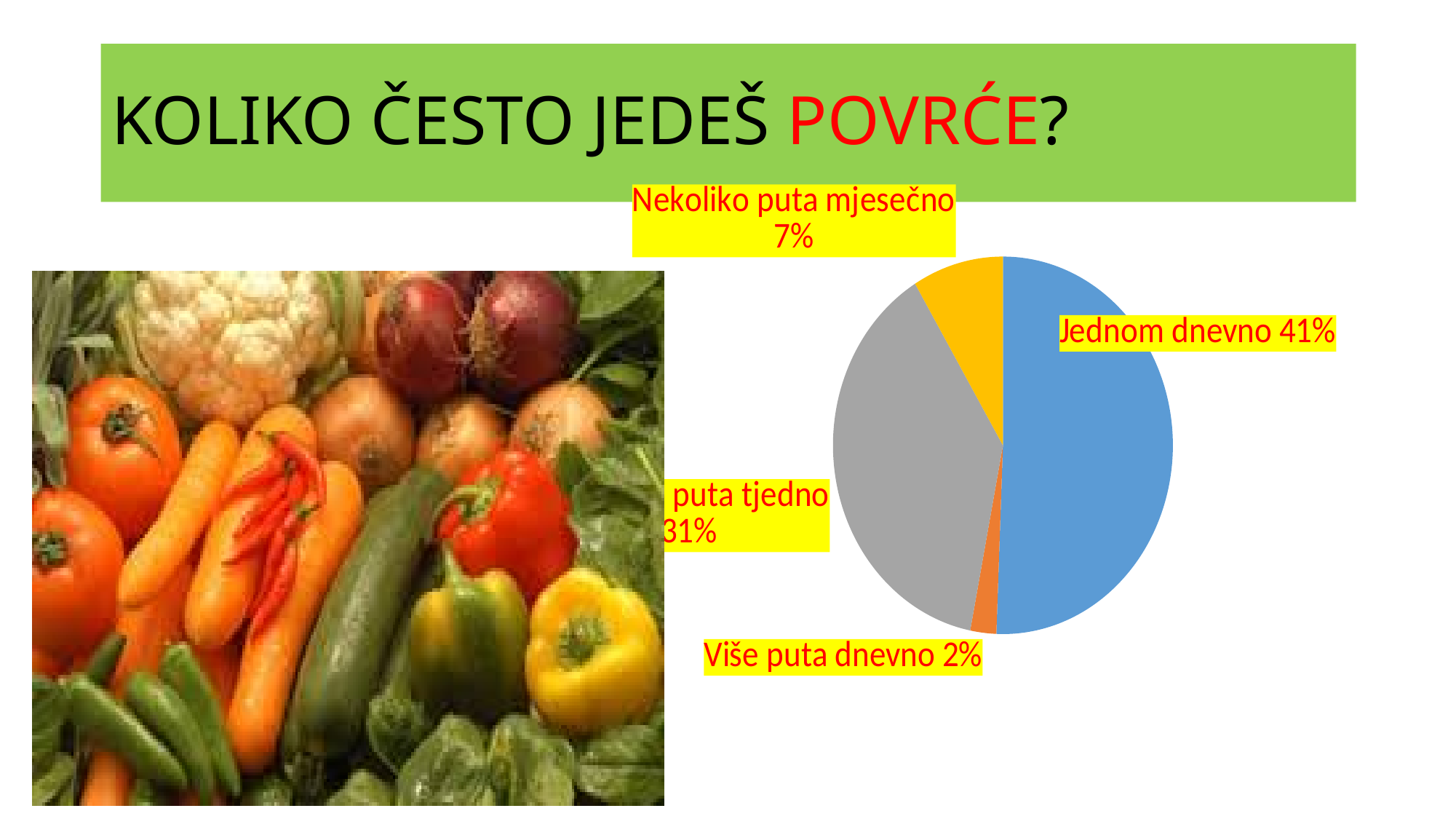
What percentage is shown for "Više puta dnevno"? 2% Which is larger, the share for "Nekoliko puta mjesečno" or for "Više puta dnevno"? Nekoliko puta mjesečno Which category has the largest share of the pie? Jednom dnevno What percentage is shown for "Jednom dnevno"? 41% Which category has the smallest share of the pie? Više puta dnevno What is the difference between the shares for "Jednom dnevno" and "Nekoliko puta mjesečno"? 34% How many slices does the pie chart have? 4 What colour is the slice for "Jednom dnevno"? blue What percentage is shown for "Nekoliko puta mjesečno"? 7% What percentage is shown for the slice labelled "puta tjedno"? 31% What kind of chart is shown on the slide? pie chart What is the difference between the shares for "Jednom dnevno" and the slice labelled "puta tjedno"? 10%